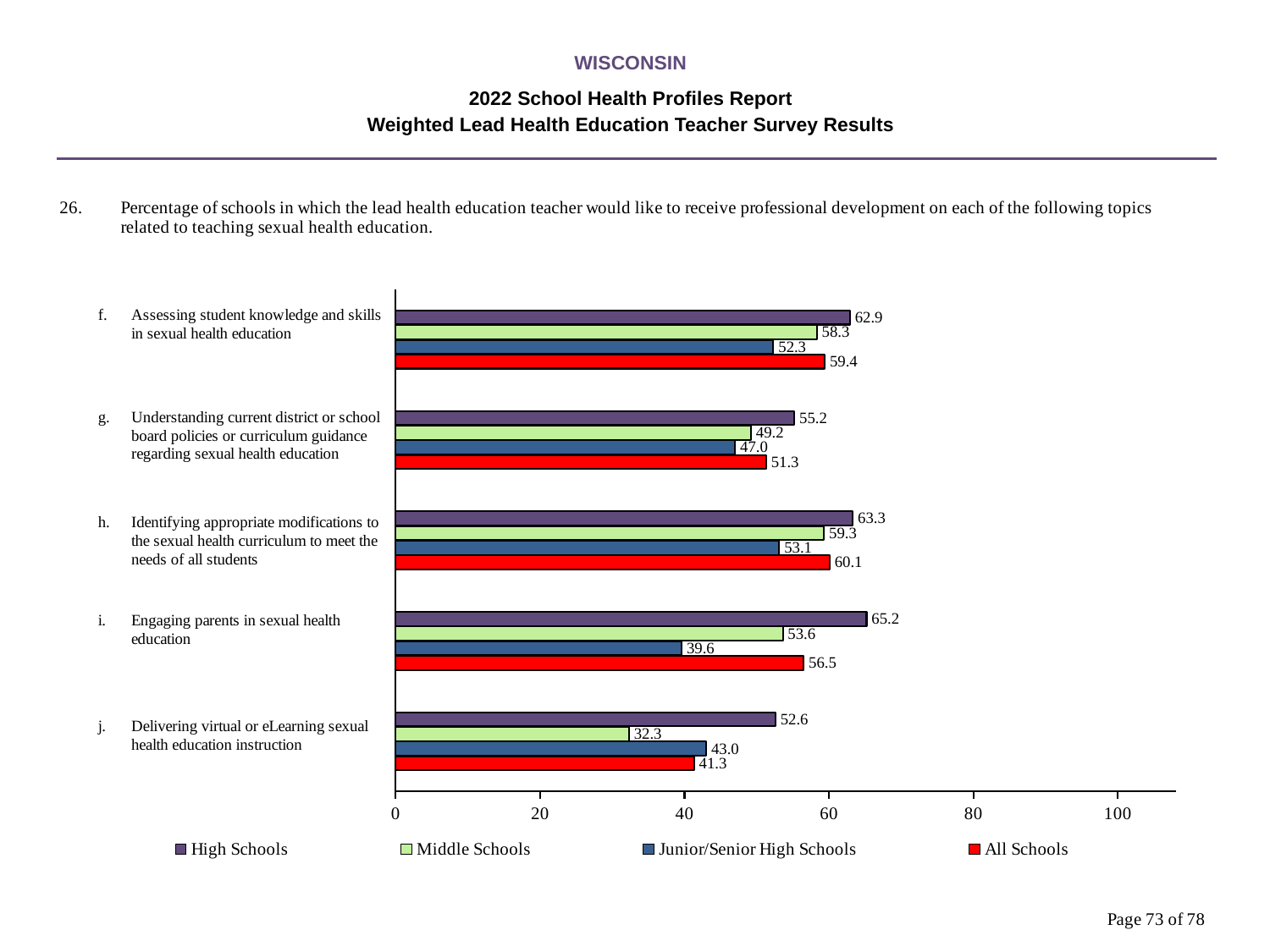
For 'Engaging parents in sexual health education', which is larger: the Middle Schools value or the Junior/Senior High Schools value? Middle Schools What is the value for Junior/Senior High Schools for 'Understanding current district or school board policies or curriculum guidance regarding sexual health education'? 47.0 Which topic has the lowest Middle Schools value? Delivering virtual or eLearning sexual health education instruction What is the All Schools value for 'Identifying appropriate modifications to the sexual health curriculum to meet the needs of all students'? 60.1 Which topic has the highest High Schools value? Engaging parents in sexual health education Is the All Schools value for 'Assessing student knowledge and skills in sexual health education' greater or less than 40? greater What is the value for Middle Schools for 'Delivering virtual or eLearning sexual health education instruction'? 32.3 What kind of chart is shown on the slide? Bar chart How many topics (categories) are shown in the chart? 5 What is the value for High Schools for 'Engaging parents in sexual health education'? 65.2 How many series does the legend list? 4 What is the difference between the High Schools and Middle Schools values for 'Delivering virtual or eLearning sexual health education instruction'? 20.3